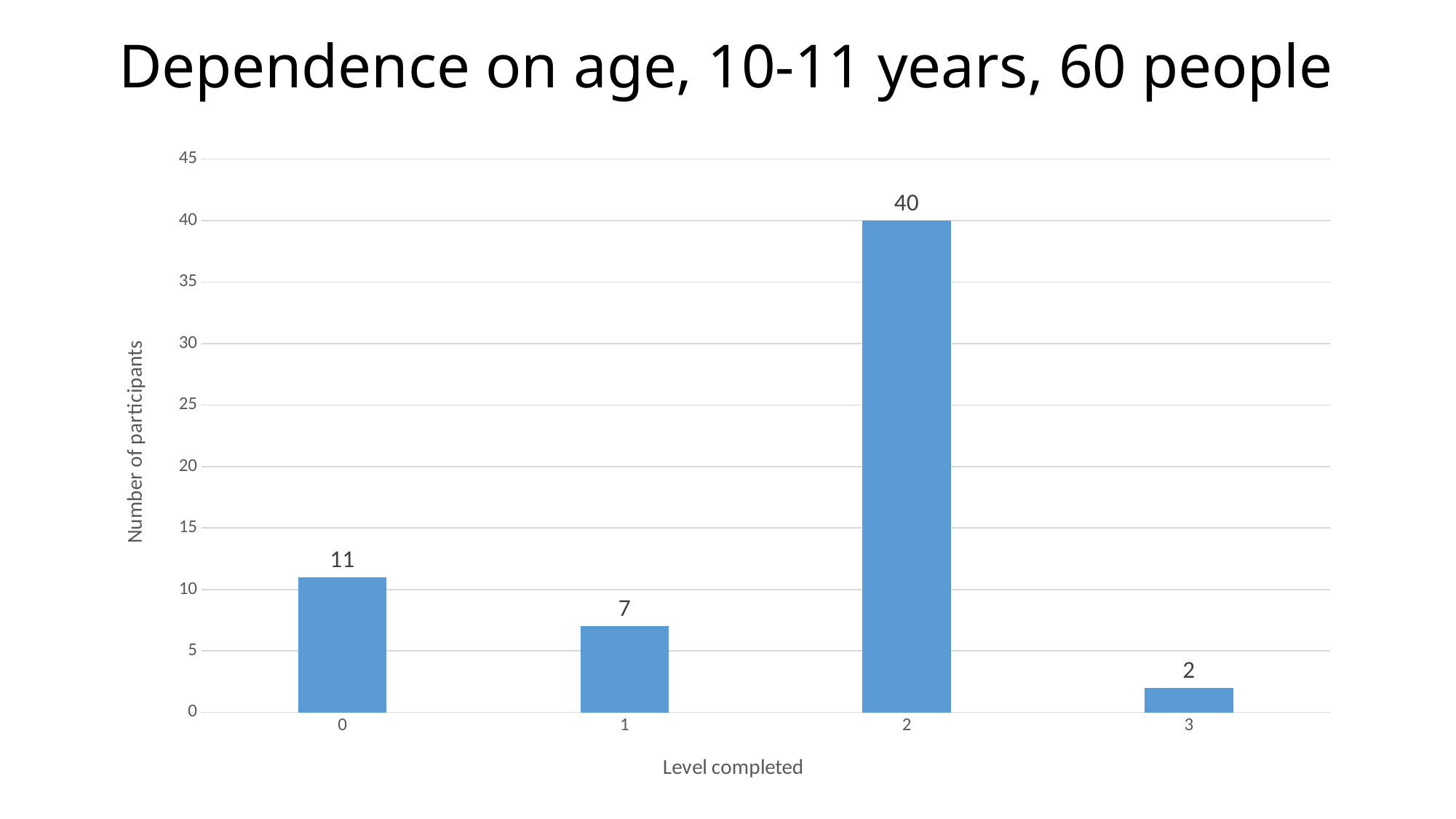
How many level categories are shown on the x axis? 4 Which has more participants, level 1 or level 3? Level 1 What is the difference in number of participants between level 2 and level 0? 29 Which level completed has the lowest number of participants? 3 What kind of chart is shown on the slide? Bar chart Is the number of participants for level 2 greater or less than 35? greater How many participants completed level 3? 2 What is the title of the chart? Dependence on age, 10-11 years, 60 people How many participants completed level 0? 11 How many participants completed level 2? 40 What is the difference in number of participants between level 0 and level 1? 4 Which level completed has the highest number of participants? 2